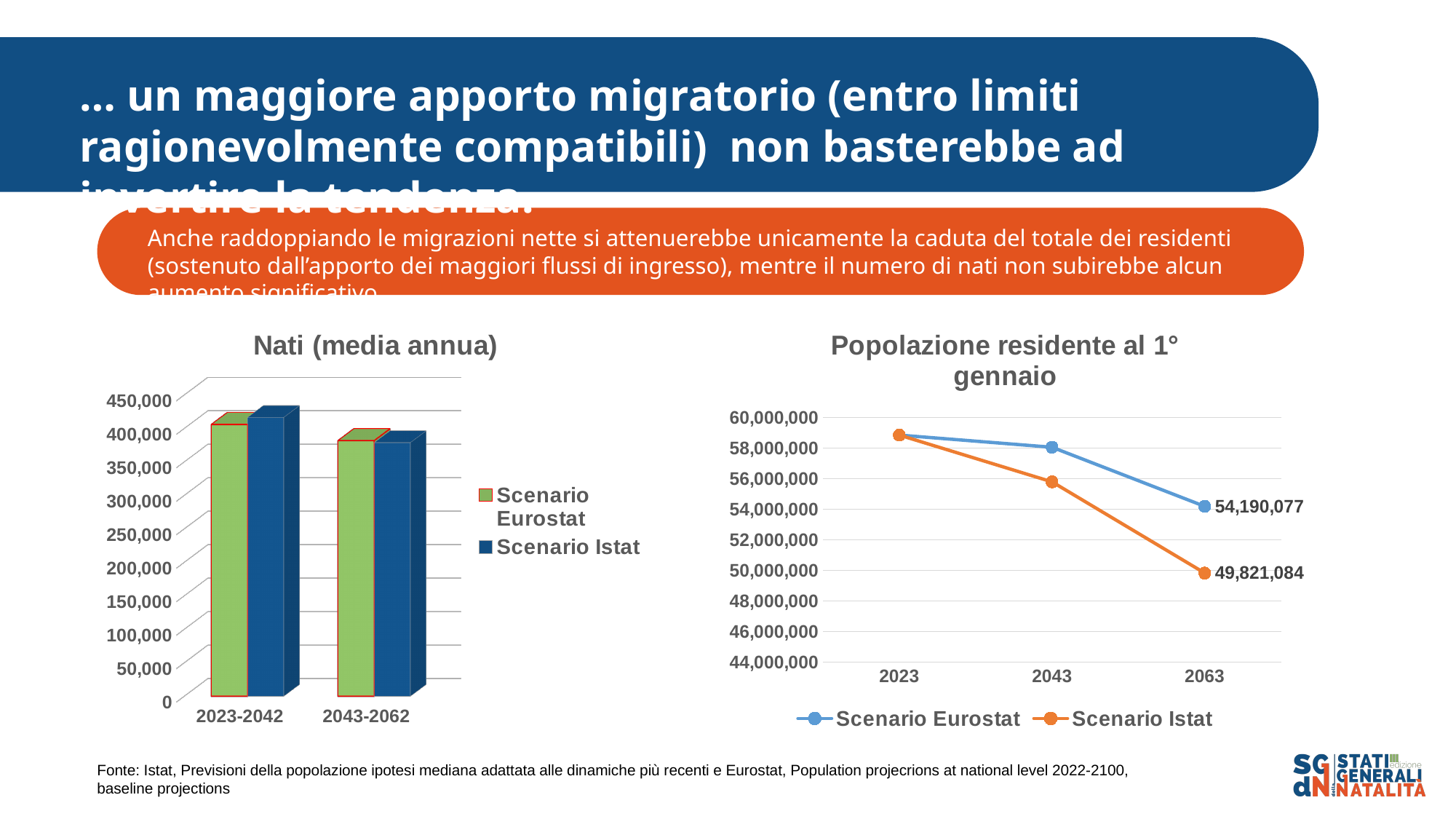
In the "Popolazione residente al 1° gennaio" chart, how many years are plotted on the x axis? 3 What kind of chart is "Nati (media annua)"? bar chart In the "Popolazione residente al 1° gennaio" chart, what is the difference between the Scenario Eurostat and Scenario Istat values in 2063? 4,368,993 In the "Nati (media annua)" chart, is the value for Scenario Istat in 2023-2042 greater or less than 400,000? greater In the "Nati (media annua)" chart, how many categories are shown on the x axis? 2 In the "Popolazione residente al 1° gennaio" chart, what is the value for Scenario Istat in 2063? 49,821,084 In the "Nati (media annua)" chart, do the Scenario Istat values rise or fall from 2023-2042 to 2043-2062? fall In the "Popolazione residente al 1° gennaio" chart, what is the value for Scenario Eurostat in 2063? 54,190,077 In the "Nati (media annua)" chart, how many series does the legend list? 2 In the "Nati (media annua)" chart, is the value for Scenario Eurostat in 2043-2062 greater or less than 400,000? less In the "Popolazione residente al 1° gennaio" chart, which series has the larger value in 2063, Scenario Eurostat or Scenario Istat? Scenario Eurostat What kind of chart is "Popolazione residente al 1° gennaio"? line chart